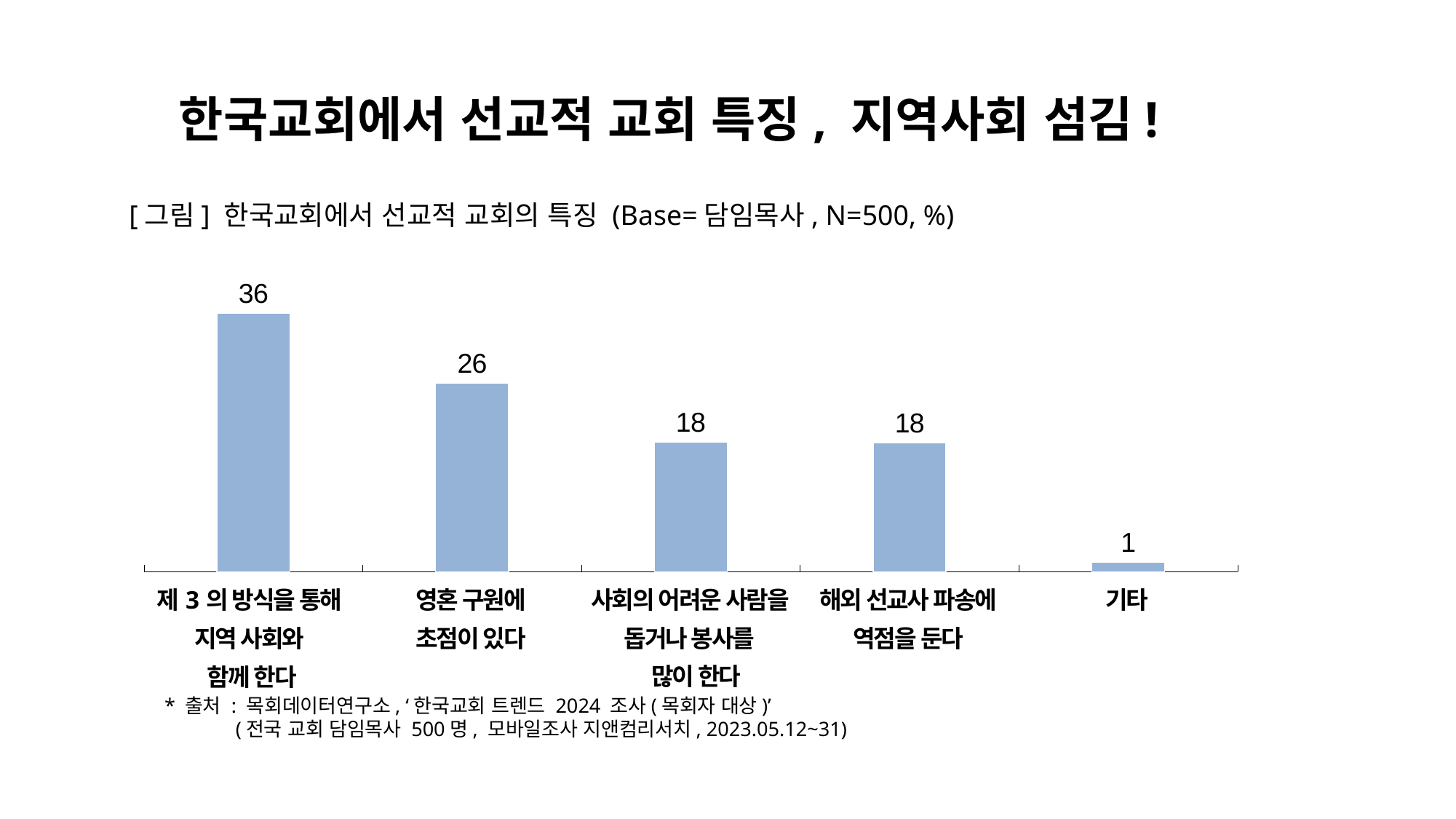
What is the value for '영혼 구원에 초점이 있다'? 26 Which is larger, the value for '영혼 구원에 초점이 있다' or the value for '해외 선교사 파송에 역점을 둔다'? 영혼 구원에 초점이 있다 Which category has the lowest value? 기타 What is the base (N) stated in the chart caption? N=500 What is the value for '제 3 의 방식을 통해 지역 사회와 함께 한다'? 36 What kind of chart is shown on the slide? Bar chart What is the value for '해외 선교사 파송에 역점을 둔다'? 18 What is the difference between the values for '영혼 구원에 초점이 있다' and '사회의 어려운 사람을 돕거나 봉사를 많이 한다'? 8 Which category has the highest value? 제 3 의 방식을 통해 지역 사회와 함께 한다 How many categories are shown in the chart? 5 What is the value for '기타'? 1 What is the difference between the values for '제 3 의 방식을 통해 지역 사회와 함께 한다' and '영혼 구원에 초점이 있다'? 10